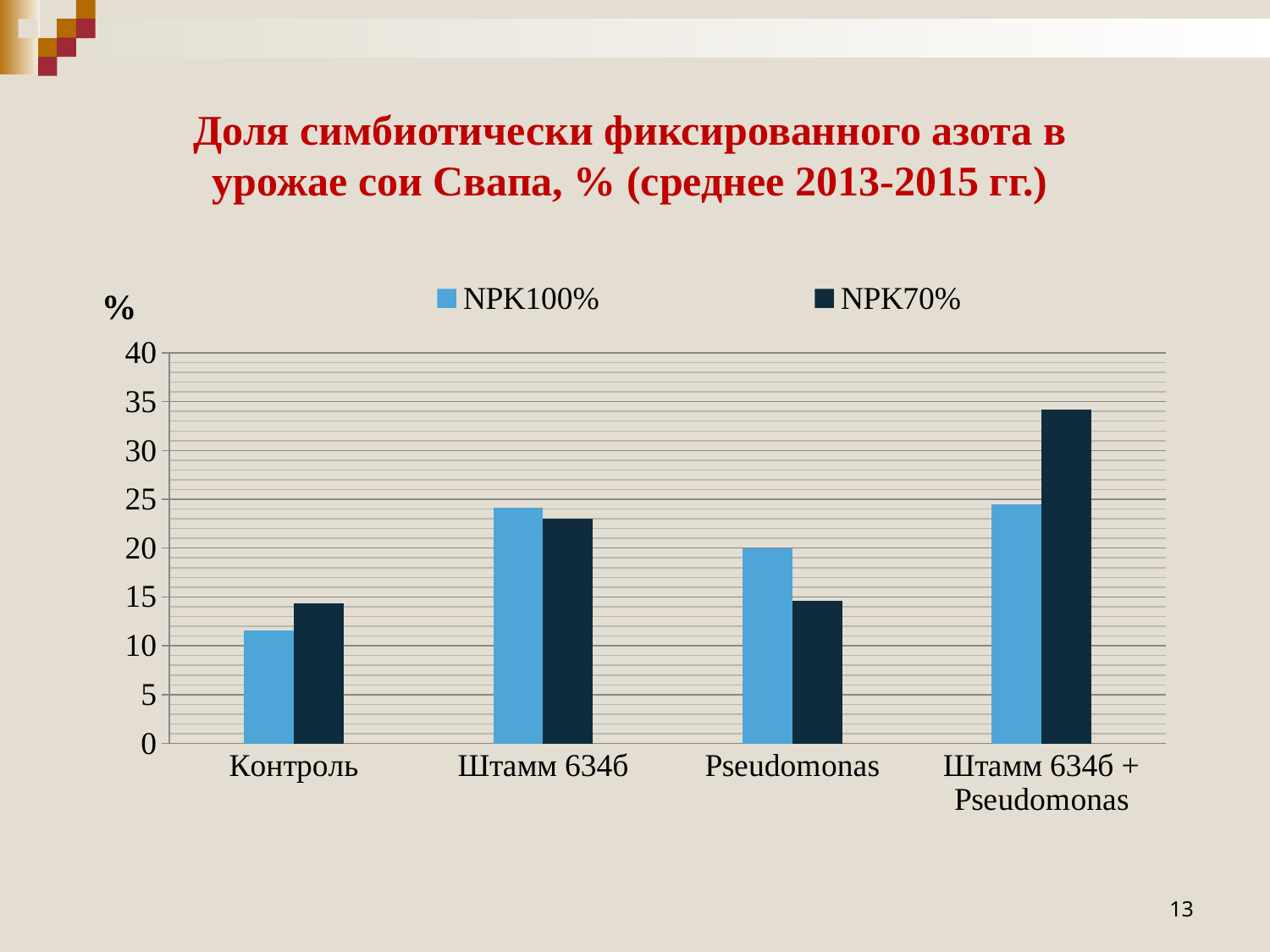
Is the NPK100% value for Контроль greater or less than 15? less For Штамм 634б + Pseudomonas, which series has the larger value, NPK100% or NPK70%? NPK70% Which category has the highest NPK70% value? Штамм 634б + Pseudomonas How many series does the legend list? 2 Which category has the lowest NPK100% value? Контроль How many categories are shown on the x axis of the chart? 4 For Pseudomonas, which series has the larger value, NPK100% or NPK70%? NPK100% What kind of chart is shown on the slide? bar chart Is the NPK100% value for Pseudomonas greater or less than 15? greater What are the two series named in the legend? NPK100% and NPK70% Is the NPK70% value for Штамм 634б + Pseudomonas greater or less than 30? greater